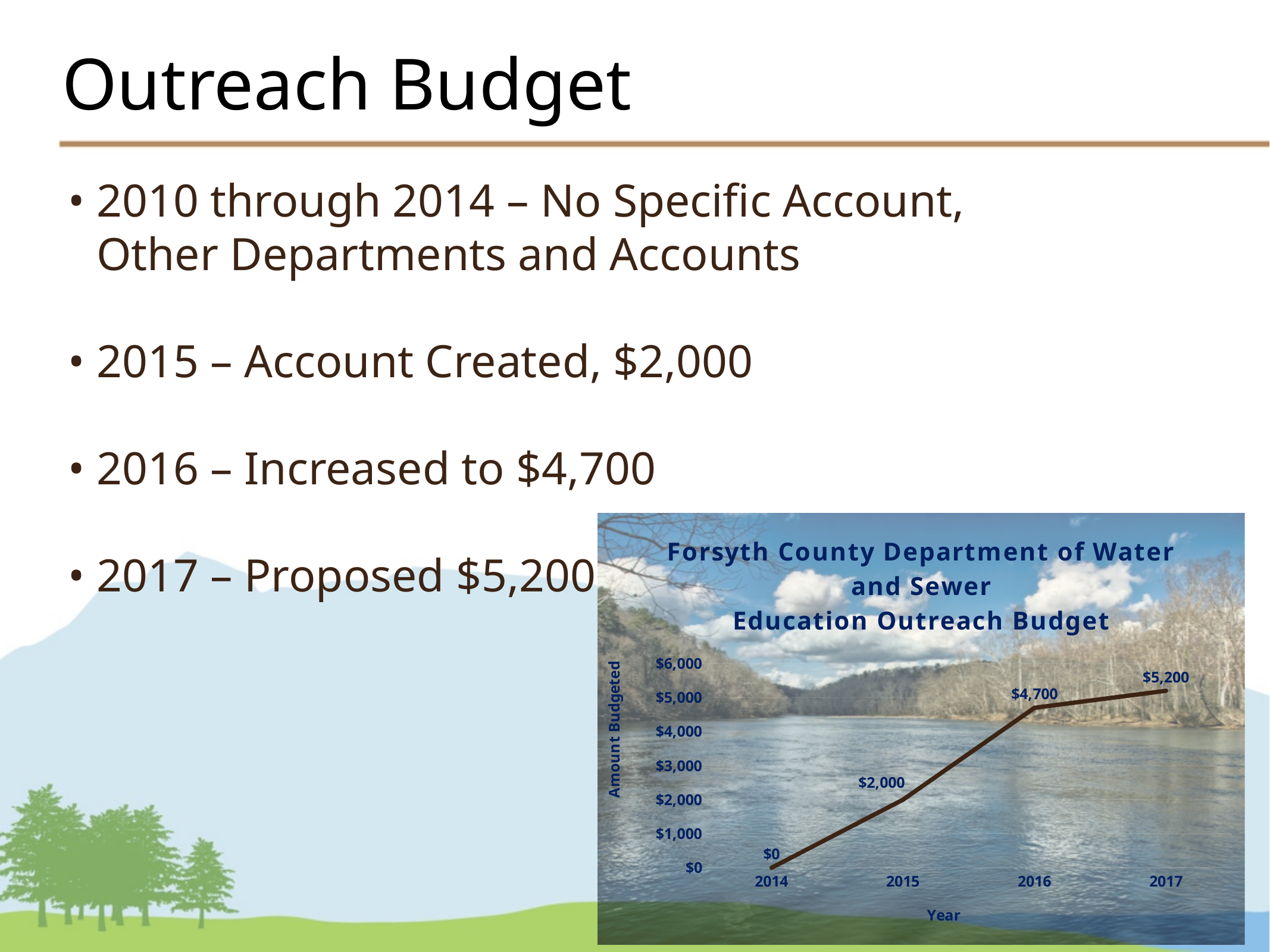
Which year has a larger amount budgeted, 2015 or 2016? 2016 What is the amount budgeted for 2015? $2,000 Which year has the lowest amount budgeted? 2014 Does the amount budgeted rise or fall from 2014 to 2017? Rise What is the amount budgeted for 2016? $4,700 What is the amount budgeted for 2017? $5,200 What kind of chart is shown on the slide? Line chart What is the difference between the amount budgeted in 2017 and in 2016? $500 How many years are plotted on the chart? 4 What is the difference between the amount budgeted in 2016 and in 2015? $2,700 Which year has the highest amount budgeted? 2017 What is the amount budgeted for 2014? $0